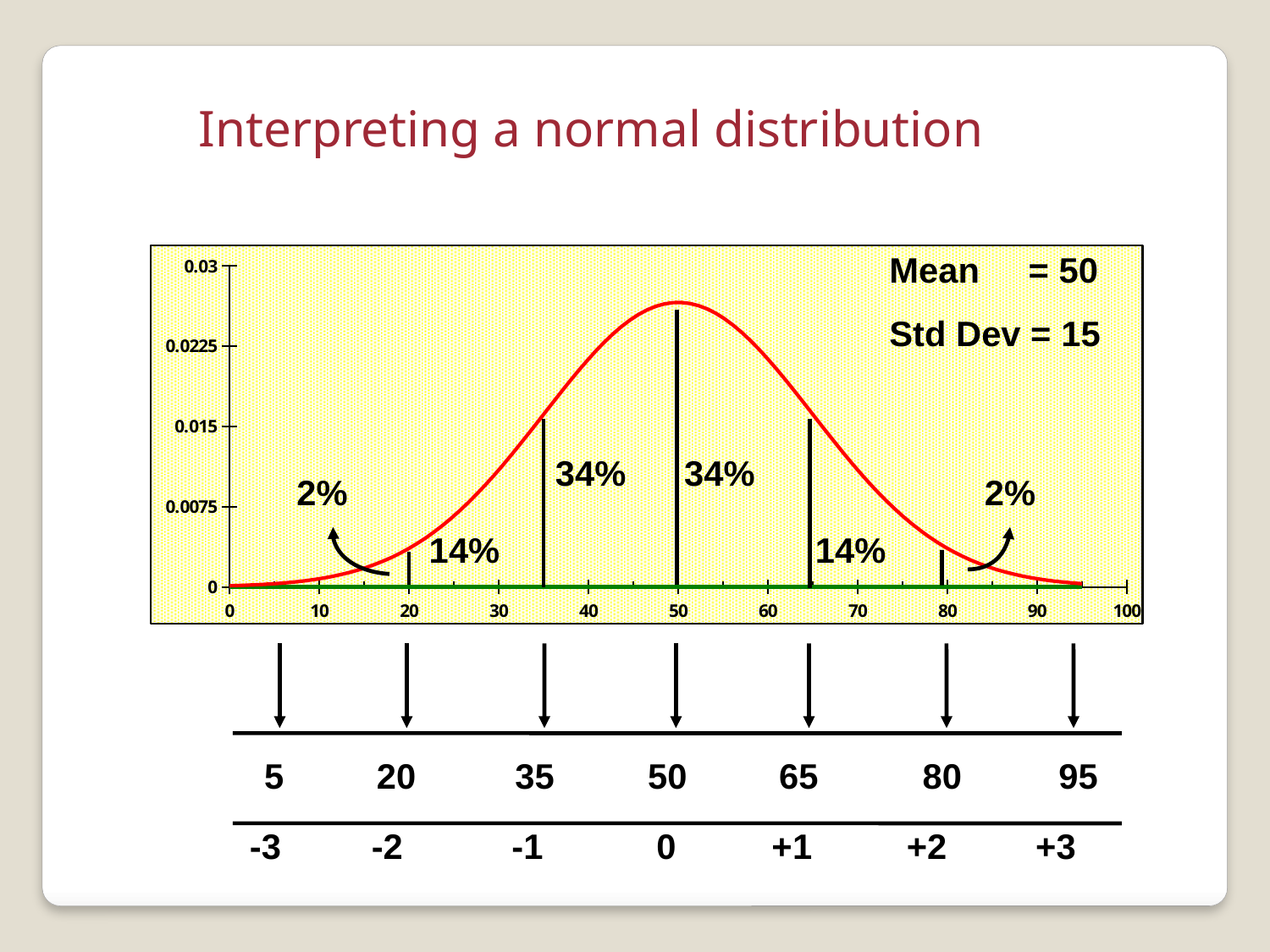
What kind of chart is shown on the slide? line chart What is the combined percentage of the two regions between 35 and 65? 68% How many percentage labels are printed on the chart? 6 What is the title of the chart on the slide? Interpreting a normal distribution What is the difference between the 34% region and the 14% region? 20% Which labelled region has the larger percentage: between 35 and 50, or between 20 and 35? between 35 and 50 What percentage is labelled for the region between 35 and 50 on the x axis? 34% According to the scale below the chart, what score corresponds to +2 standard deviations? 80 What percentage is labelled for the tail below 20 on the x axis? 2% What mean value is stated on the chart? 50 What percentage is labelled for the region between 65 and 80 on the x axis? 14% What standard deviation is stated on the chart? 15